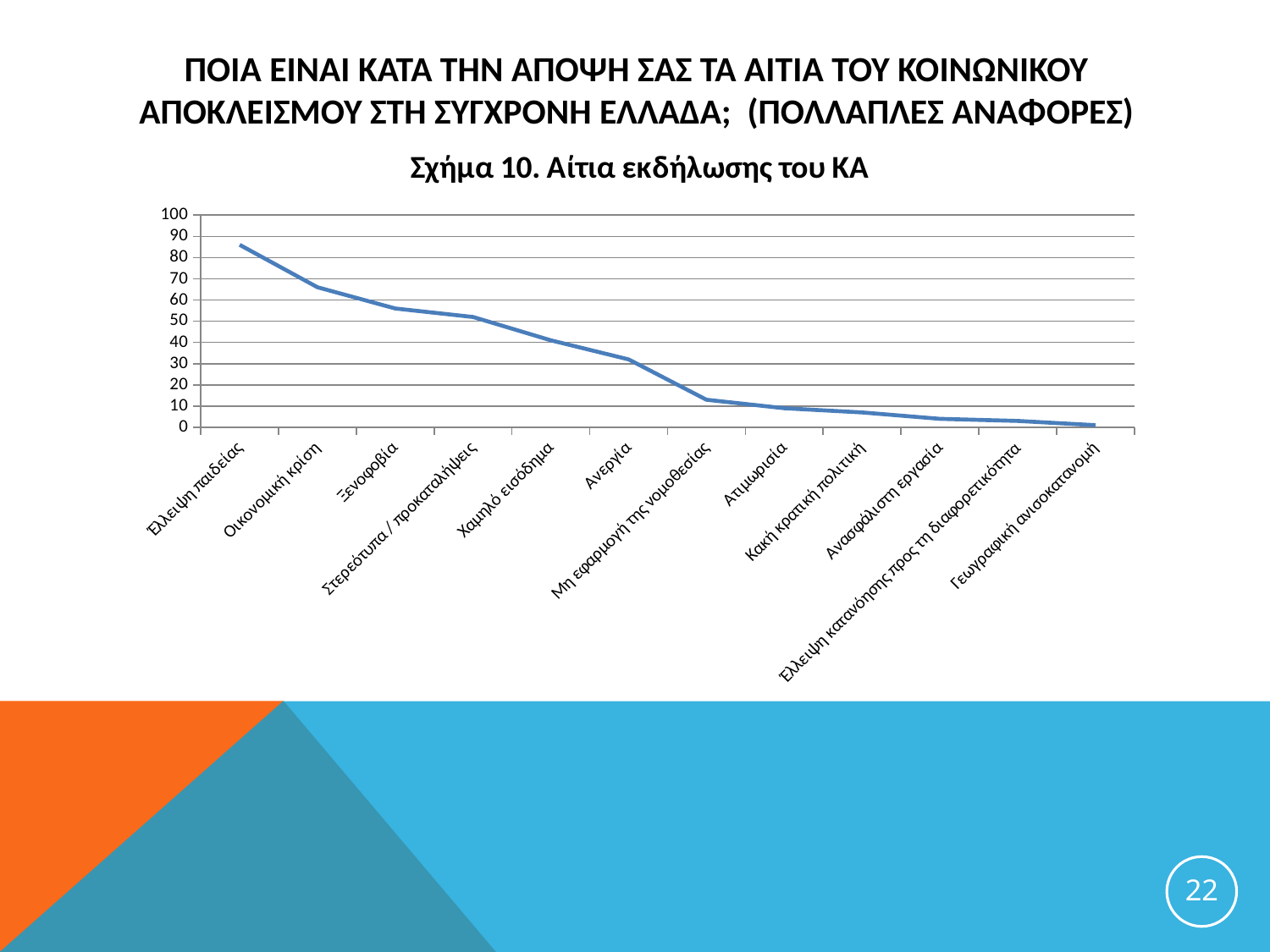
Is the value for Έλλειψη παιδείας greater or less than 80? greater Is the value for Μη εφαρμογή της νομοθεσίας greater or less than 20? less Is the value for Οικονομική κρίση greater or less than 60? greater Do the values rise or fall moving from left to right along the x axis? fall Which has the larger value, Ξενοφοβία or Χαμηλό εισόδημα? Ξενοφοβία What kind of chart is shown on the slide? line chart How many categories are plotted along the x axis of the chart? 12 Which has the larger value, Ατιμωρησία or Ανασφάλιστη εργασία? Ατιμωρισία Which category has the lowest value in the chart? Γεωγραφική ανισοκατανομή What is the title of the chart? Σχήμα 10. Αίτια εκδήλωσης του ΚΑ Which category has the highest value in the chart? Έλλειψη παιδείας